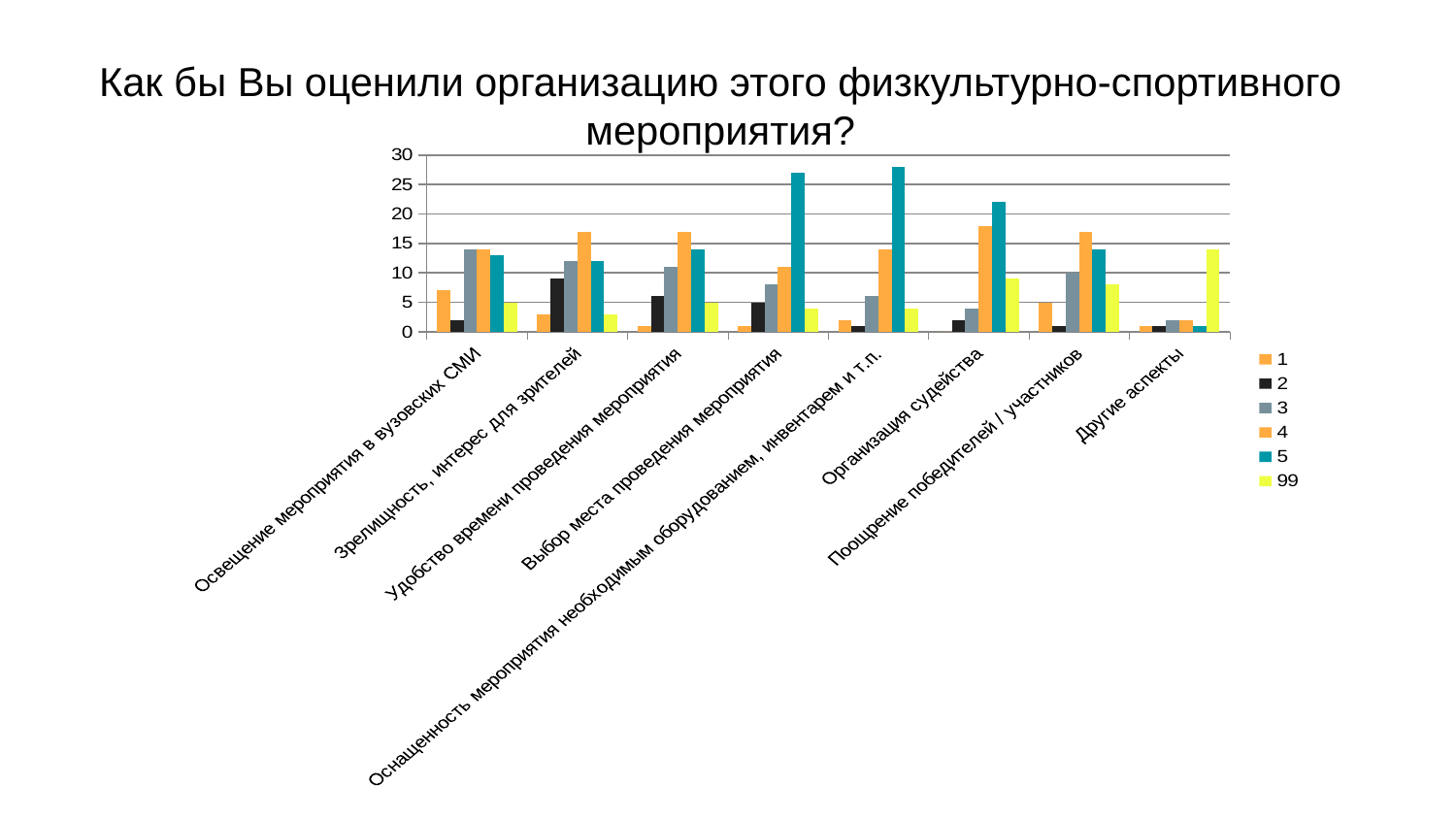
Which series has the highest value for the category 'Выбор места проведения мероприятия'? 5 Is the value of series 5 for 'Оснащенность мероприятия необходимым оборудованием, инвентарем и т.п.' greater or less than 25? greater How many series does the legend list? 6 What kind of chart is shown on the slide? bar chart For 'Выбор места проведения мероприятия', which is larger: the value of series 5 or the value of series 4? series 5 Is the value of series 4 for 'Организация судейства' greater or less than 15? greater Is the value of series 99 for 'Другие аспекты' greater or less than 10? greater For 'Другие аспекты', which is larger: the value of series 99 or the value of series 5? series 99 What is the title of the chart? Как бы Вы оценили организацию этого физкультурно-спортивного мероприятия? How many categories are shown along the x axis of the chart? 8 Which series has the highest value for the category 'Другие аспекты'? 99